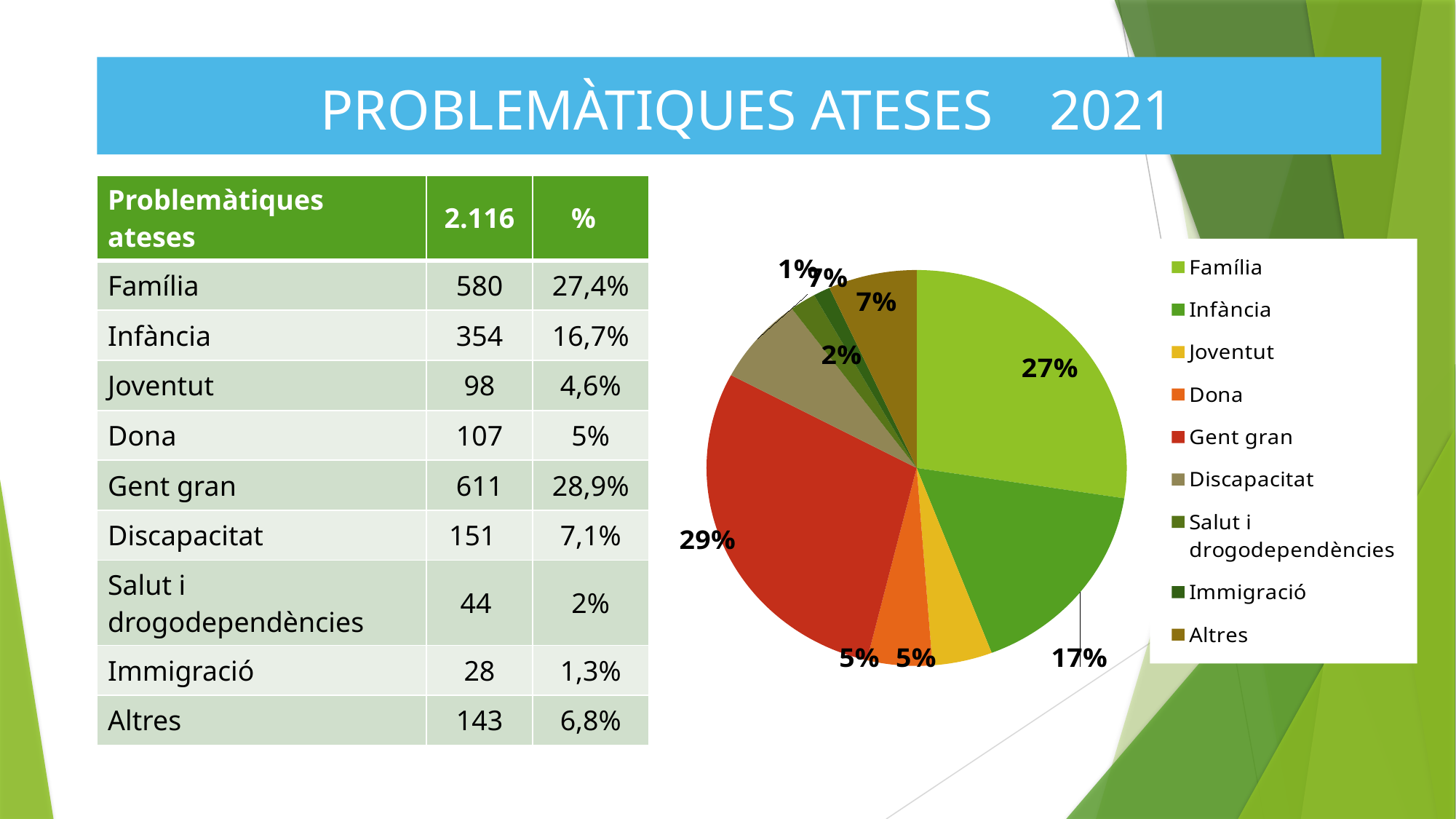
What share of the pie chart does Família represent? 27% What is the difference in percentage points between the Gent gran slice and the Infància slice in the pie chart? 12 What share of the pie chart does Altres represent? 7% How many slices does the pie chart have? 9 In the pie chart, which slice is larger: Família or Infància? Família What share of the pie chart does Infància represent? 17% Which category has the smallest slice in the pie chart? Immigració How many entries does the pie chart's legend list? 9 What kind of chart is shown on the slide? pie chart Which category has the largest slice in the pie chart? Gent gran Which colour is used for the Gent gran slice in the pie chart? red